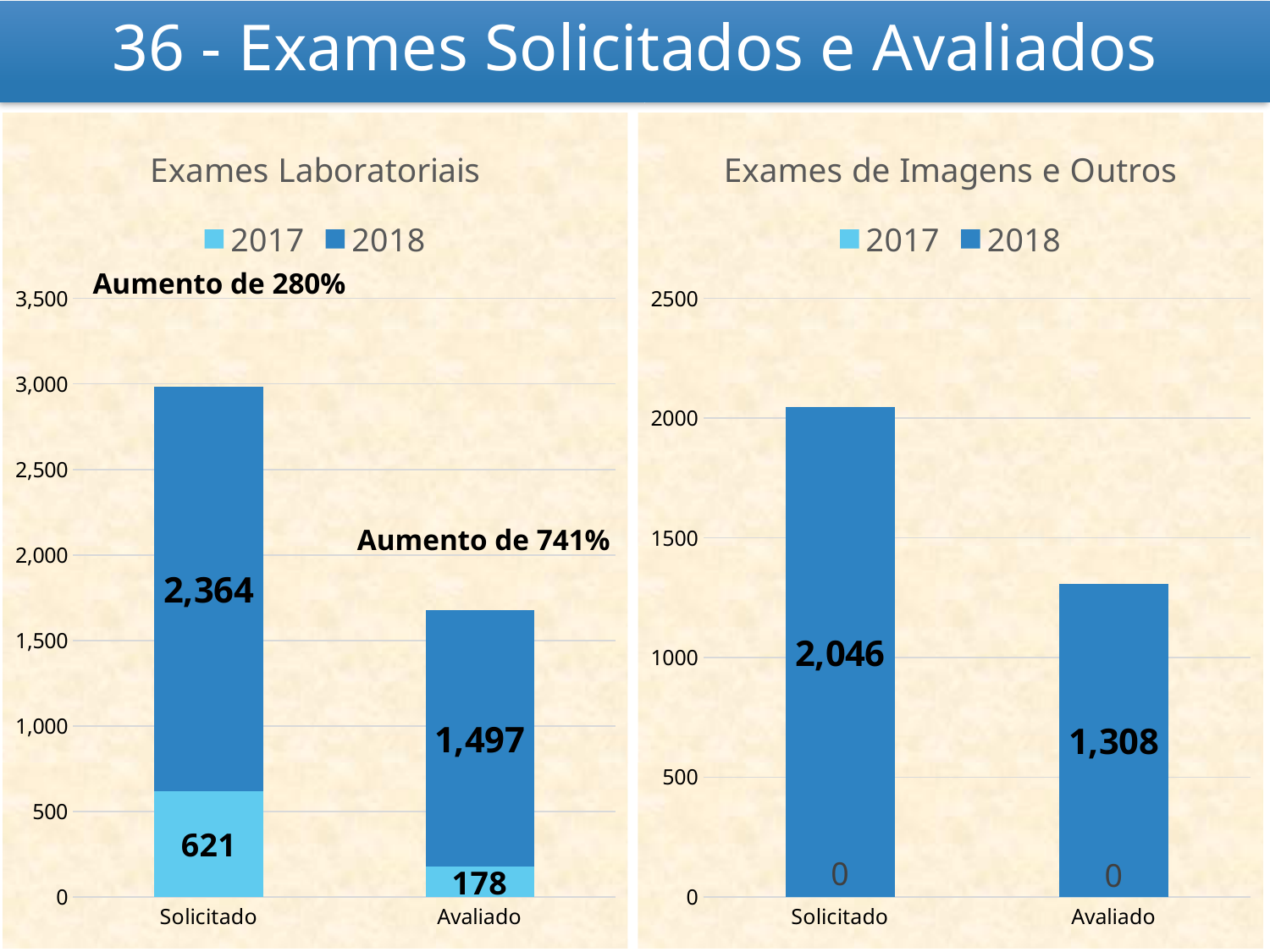
In the 'Exames de Imagens e Outros' chart, which category has the higher 2018 value, Solicitado or Avaliado? Solicitado In the 'Exames Laboratoriais' chart, what is the 2018 value for Solicitado? 2,364 In the 'Exames Laboratoriais' chart, what is the difference between the 2018 values for Solicitado and Avaliado? 867 What type of chart is 'Exames de Imagens e Outros'? Stacked bar chart In the 'Exames Laboratoriais' chart, what is the 2017 value for Avaliado? 178 In the 'Exames de Imagens e Outros' chart, what is the difference between the 2018 values for Solicitado and Avaliado? 738 How many series does the legend of the 'Exames Laboratoriais' chart list? 2 In the 'Exames de Imagens e Outros' chart, what is the 2017 value for Solicitado? 0 In the 'Exames Laboratoriais' chart, what is the 2017 value for Solicitado? 621 In the 'Exames Laboratoriais' chart, what is the total of the stacked bar for Solicitado? 2,985 In the 'Exames Laboratoriais' chart, what is the total of the stacked bar for Avaliado? 1,675 In the 'Exames de Imagens e Outros' chart, what is the 2018 value for Avaliado? 1,308